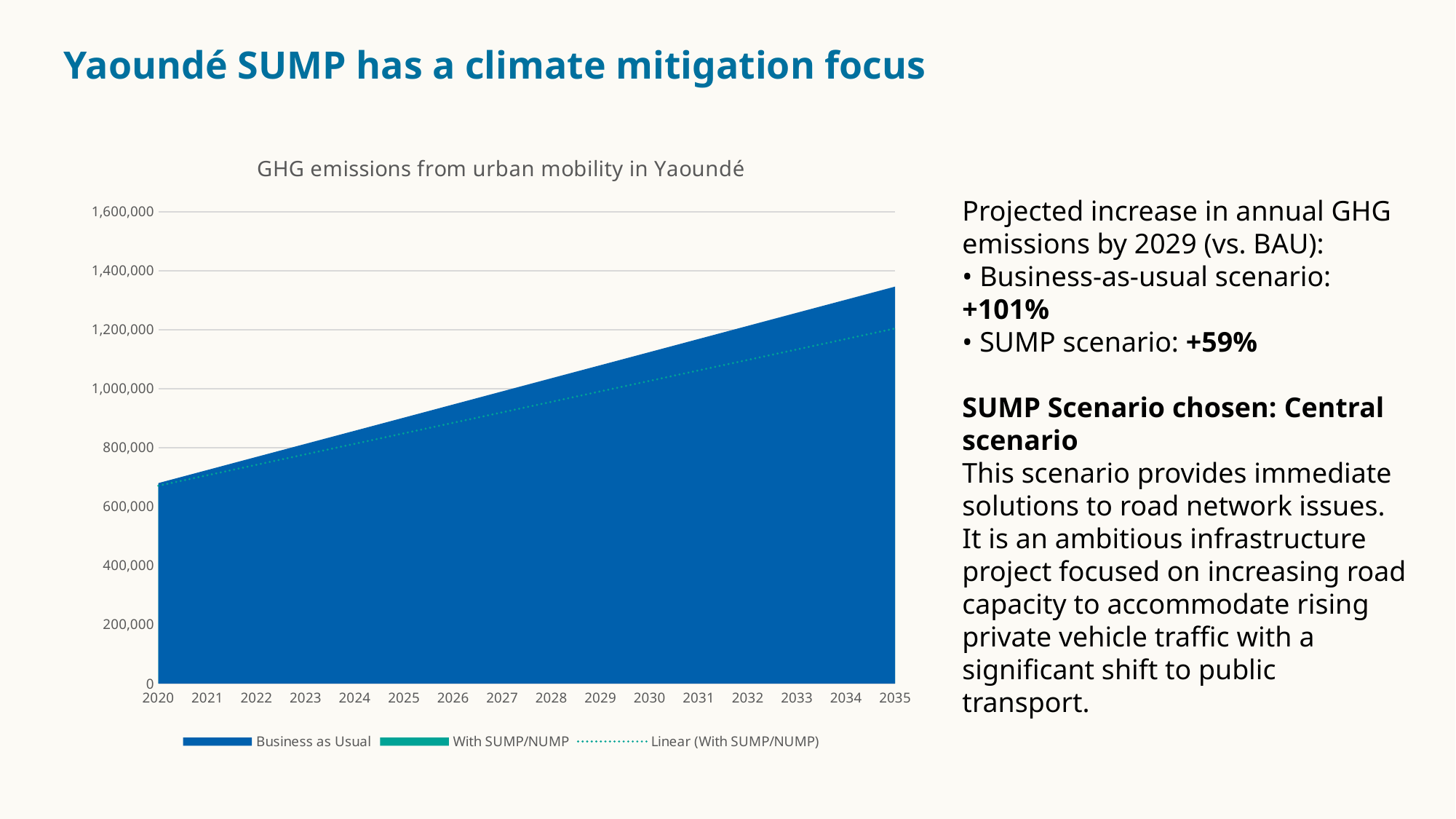
What kind of chart is shown on the slide? Area chart How many years are shown along the x axis of the chart? 16 In which year is the Business as Usual value lowest? 2020 Is the Business as Usual value for 2035 greater or less than 1,200,000? greater Is the Business as Usual value for 2030 greater or less than 1,000,000? greater How many entries does the chart legend list? 3 Which series is drawn as a dotted line in the chart? Linear (With SUMP/NUMP) In which year is the Business as Usual value highest? 2035 Is the Business as Usual value for 2020 greater or less than 600,000? greater What is the title of the chart? GHG emissions from urban mobility in Yaoundé Do the Business as Usual emissions rise or fall from 2020 to 2035? Rise